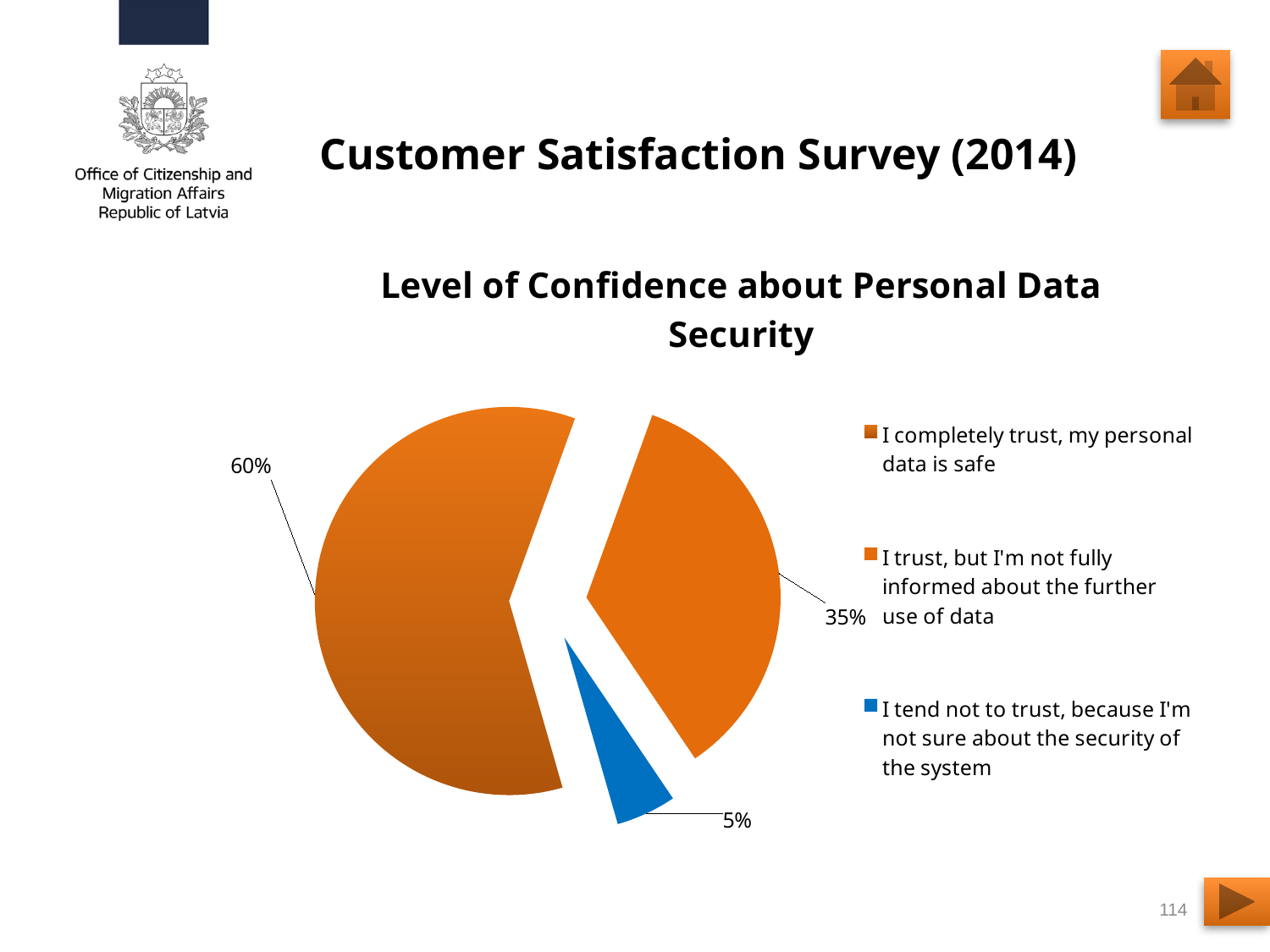
What share of respondents said "I tend not to trust, because I'm not sure about the security of the system"? 5% Which response has the largest share of the pie? I completely trust, my personal data is safe What share of respondents said "I completely trust, my personal data is safe"? 60% What kind of chart is shown on the slide? Pie chart How many entries does the legend list? 3 Which response has the smallest share of the pie? I tend not to trust, because I'm not sure about the security of the system What is the difference in percentage points between the "I completely trust" slice and the "I trust, but I'm not fully informed" slice? 25 percentage points How many slices does the pie chart have? 3 Which is larger: the share for "I trust, but I'm not fully informed about the further use of data" or the share for "I tend not to trust"? I trust, but I'm not fully informed about the further use of data What is the title of the chart? Level of Confidence about Personal Data Security What share of respondents said "I trust, but I'm not fully informed about the further use of data"? 35% What colour is the slice for "I tend not to trust, because I'm not sure about the security of the system"? Blue